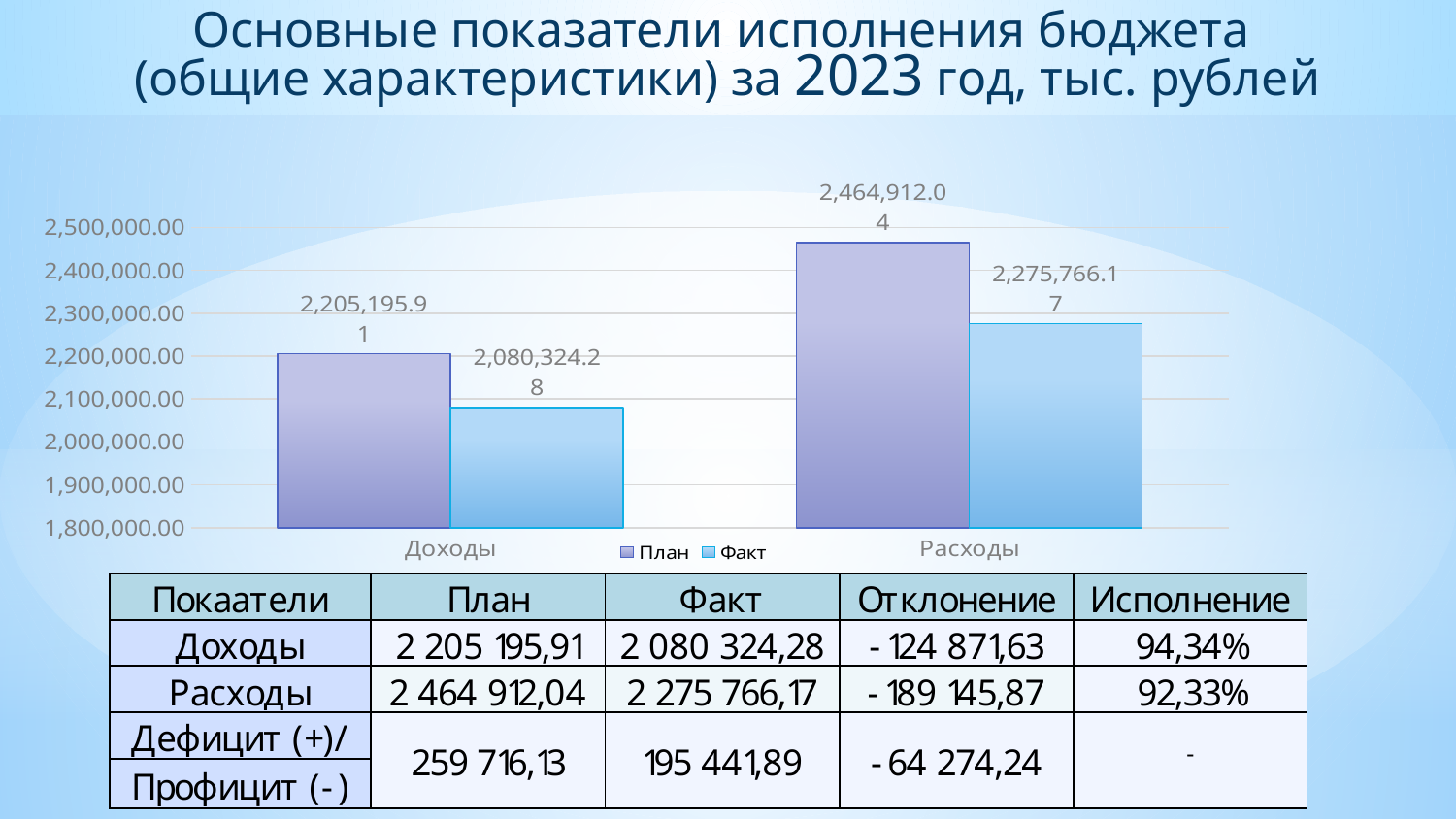
What is the difference between the План and Факт values for Доходы? 124,871.63 How many series does the legend list? 2 What kind of chart is shown on the slide? bar chart Which bar has the lowest value on the chart? Факт for Доходы What is the Факт value for Доходы? 2,080,324.28 What is the Факт value for Расходы? 2,275,766.17 What is the План value for Доходы? 2,205,195.91 What is the difference between the План and Факт values for Расходы? 189,145.87 Is the Факт value for Доходы greater or less than 2,100,000.00? less Which bar has the highest value on the chart? План for Расходы Which is larger: the Факт value for Доходы or the Факт value for Расходы? Факт for Расходы How many categories are shown on the x axis? 2